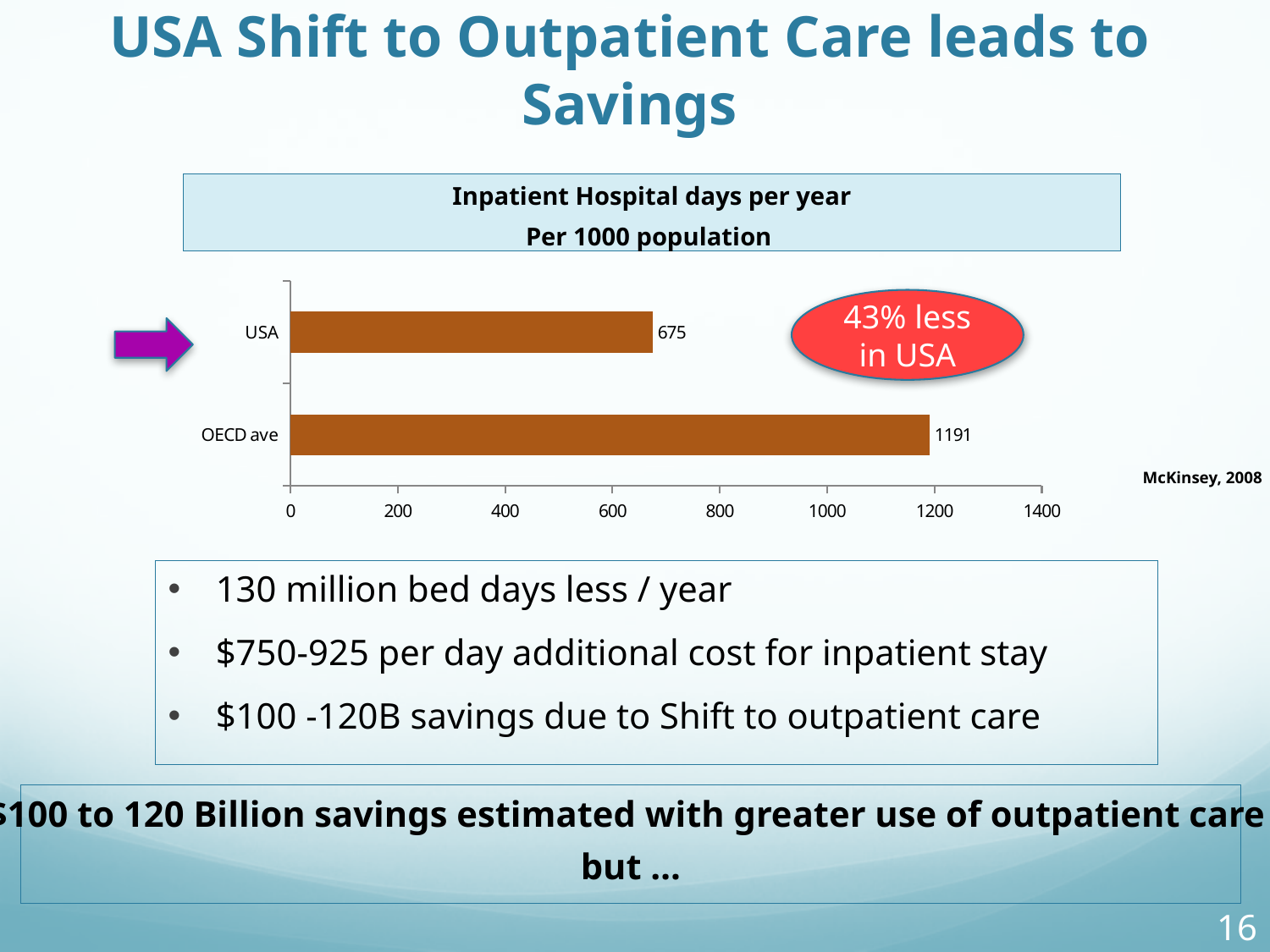
Is the value for USA greater or less than 800? less What is the title of the chart? Inpatient Hospital days per year Per 1000 population What is the value for USA in the chart? 675 Which category has the lowest value in the chart? USA Is the value for OECD ave greater or less than 1000? greater Which category has the highest value in the chart? OECD ave Which is larger, the value for USA or the value for OECD ave? OECD ave How many categories are shown in the chart? 2 What is the maximum value shown on the x axis of the chart? 1400 What is the value for OECD ave in the chart? 1191 What is the difference between the OECD ave value and the USA value? 516 What kind of chart is shown on the slide? bar chart